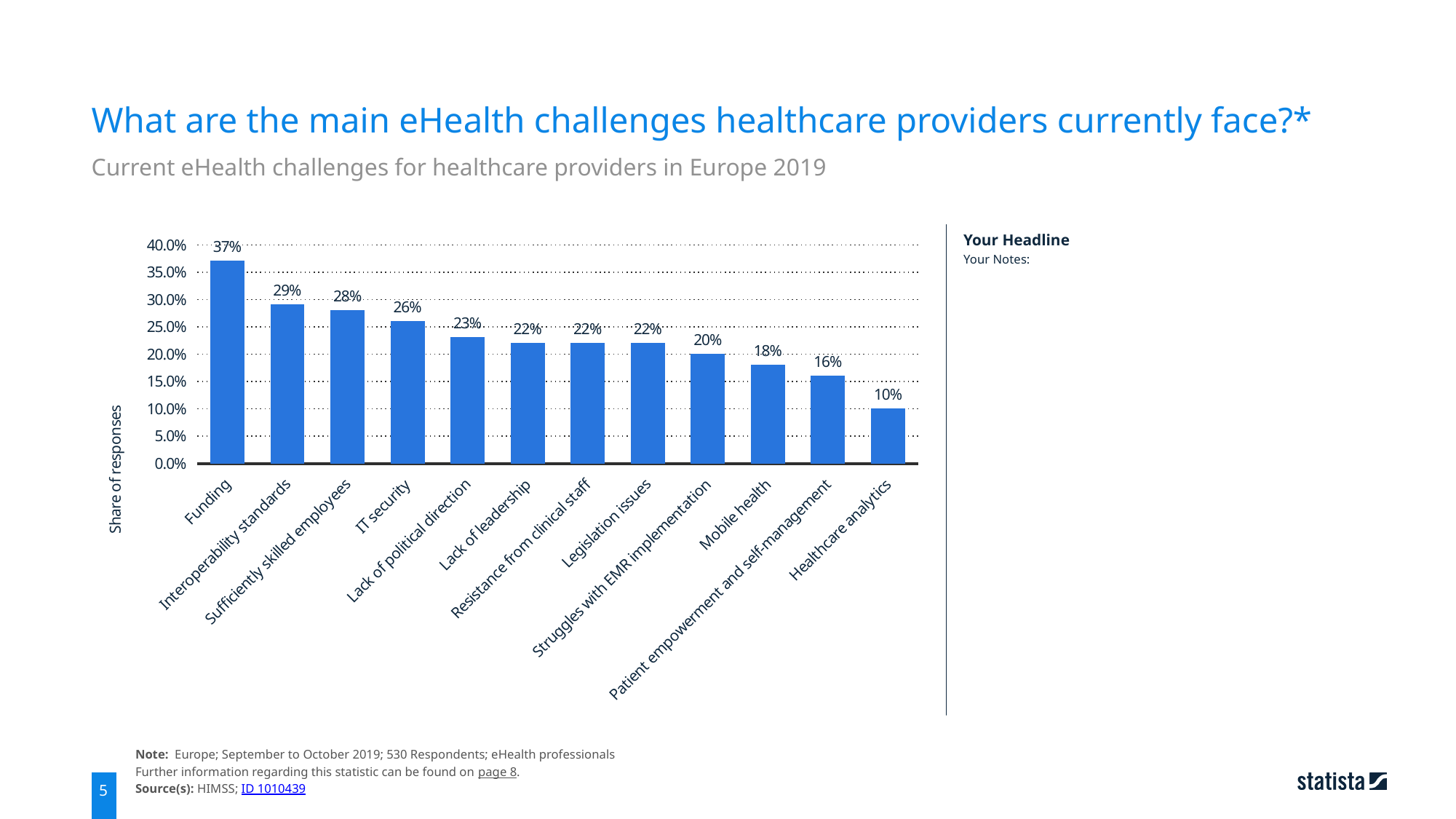
Which is larger, the value for Sufficiently skilled employees or the value for Lack of political direction? Sufficiently skilled employees Which category has the lowest value? Healthcare analytics What kind of chart is shown on the slide? Bar chart How many categories are shown on the x axis? 12 What is the value for IT security? 26% What is the difference between the values for Funding and Interoperability standards? 8% What is the label of the vertical axis? Share of responses What is the value for Funding? 37% Which category has the highest value? Funding What is the value for Mobile health? 18% What is the difference between the values for Struggles with EMR implementation and Healthcare analytics? 10% What is the value for Patient empowerment and self-management? 16%